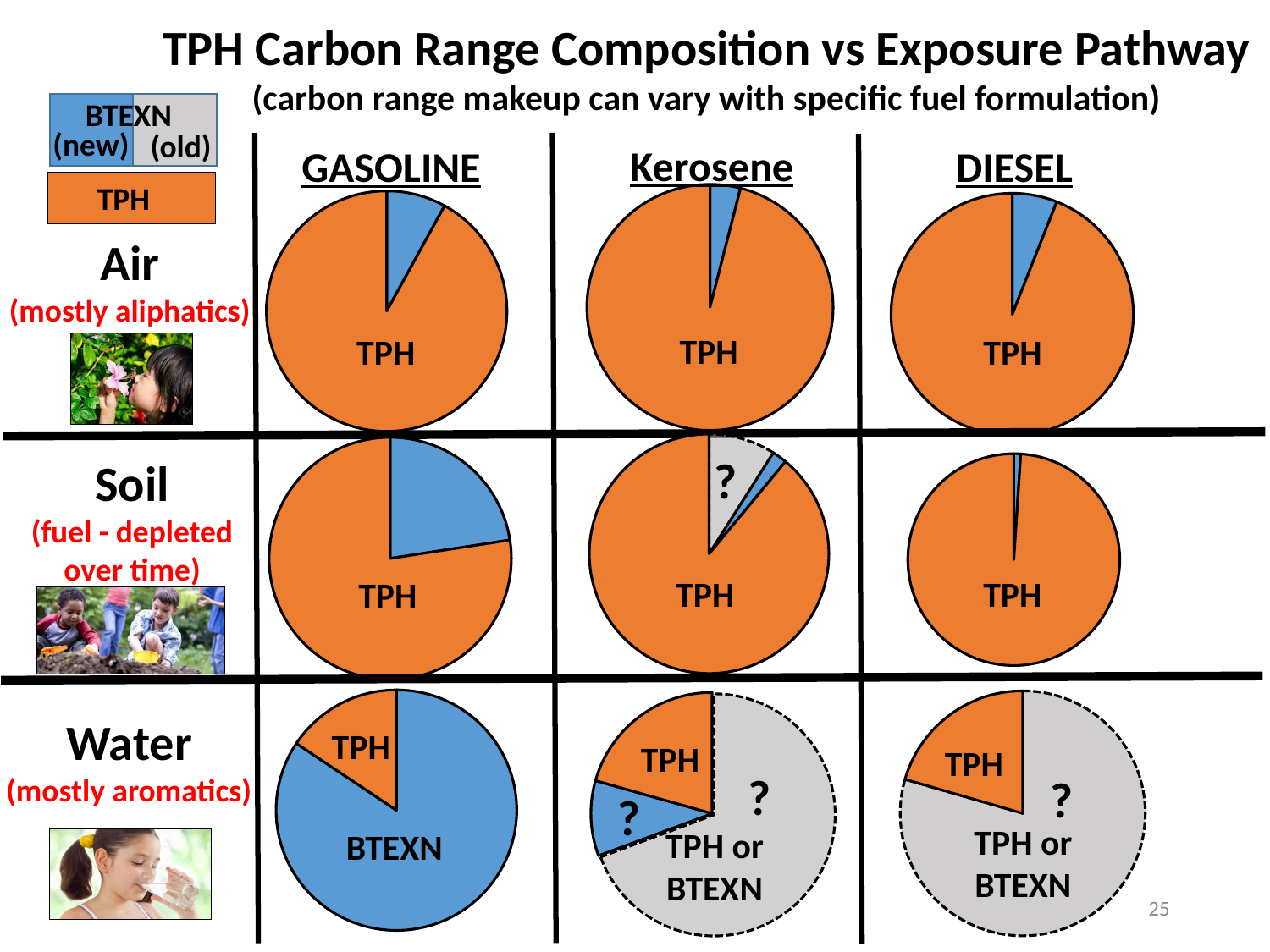
In the Gasoline / Air pie chart, which slice is larger, the orange TPH slice or the blue slice? TPH What kind of chart is used in each cell of the grid on this slide? Pie chart In the Diesel / Water pie chart, which slice is larger, the orange TPH slice or the grey "TPH or BTEXN" slice? TPH or BTEXN According to the legend, which colour represents TPH? Orange In the Gasoline / Water pie chart, which slice is larger, TPH or BTEXN? BTEXN How many pie charts are shown on the slide? 9 What is the title of the slide containing the pie charts? TPH Carbon Range Composition vs Exposure Pathway Which fuel column's Soil pie chart has the largest blue slice? Gasoline What label is printed on the grey slice of the Kerosene / Water pie chart? ? TPH or BTEXN How many slices does the Diesel / Water pie chart have? 2 How many slices does the Kerosene / Soil pie chart have? 3 Which fuel column's Soil pie chart has the smallest blue slice? Diesel